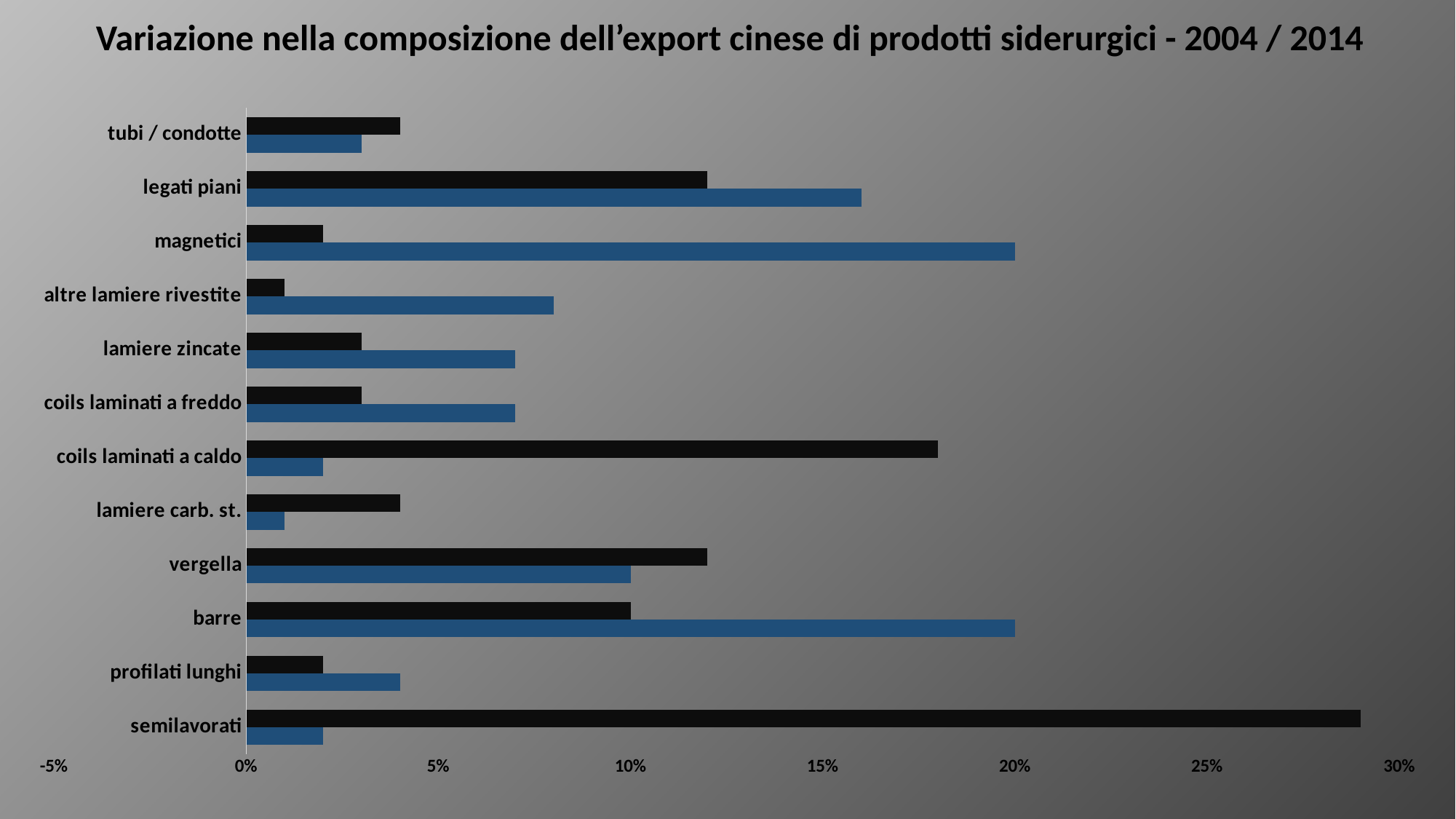
Which category has the longest bar on the chart? semilavorati Is the value of the black bar for semilavorati greater or less than 25%? greater What is the value of the black bar for barre? 10% What kind of chart is shown on the slide? bar chart How many product categories are listed on the chart? 12 What is the difference between the blue bar and the black bar for barre? 10 percentage points What is the value of the blue bar for vergella? 10% What is the title of the chart? Variazione nella composizione dell'export cinese di prodotti siderurgici - 2004 / 2014 For magnetici, which is larger: the black bar or the blue bar? the blue bar Is the value of the black bar for coils laminati a caldo greater or less than 15%? greater What is the value of the blue bar for barre? 20% What is the value of the blue bar for magnetici? 20%